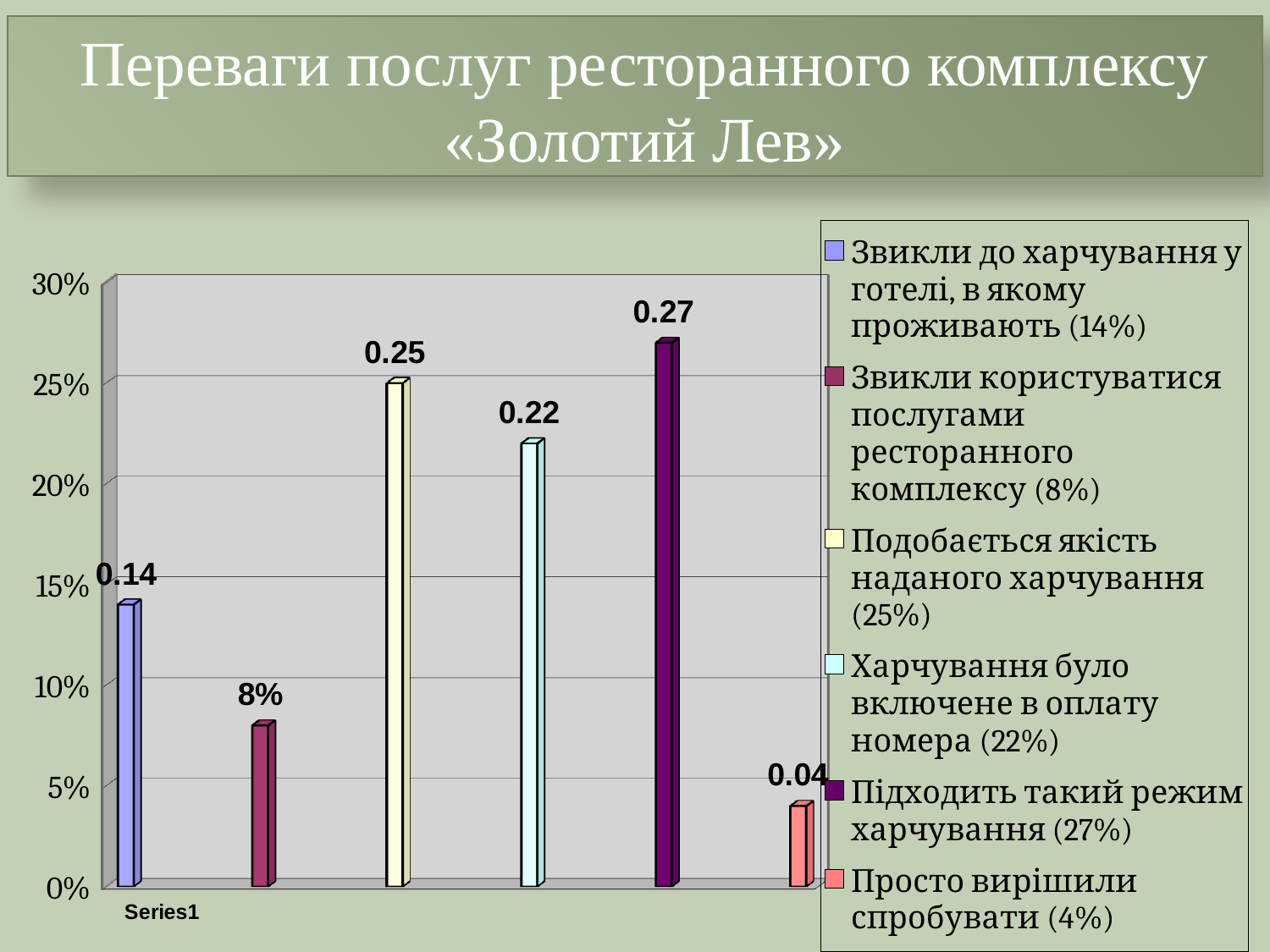
Is the value for "Підходить такий режим харчування" greater or less than 25%? greater What value is shown on the bar for "Харчування було включене в оплату номера"? 0.22 What type of chart is shown on the slide? bar chart What is the difference between the values for "Подобається якість наданого харчування" and "Харчування було включене в оплату номера"? 0.03 Which legend category has the lowest bar? Просто вирішили спробувати What value is shown on the bar for "Просто вирішили спробувати"? 0.04 Which legend category has the highest bar? Підходить такий режим харчування Which is larger: the value for "Подобається якість наданого харчування" or for "Харчування було включене в оплату номера"? Подобається якість наданого харчування How many entries does the legend list? 6 What value is shown on the bar for "Звикли користуватися послугами ресторанного комплексу"? 8% What value is shown on the bar for "Звикли до харчування у готелі, в якому проживають"? 0.14 How many bars are plotted on the chart? 6